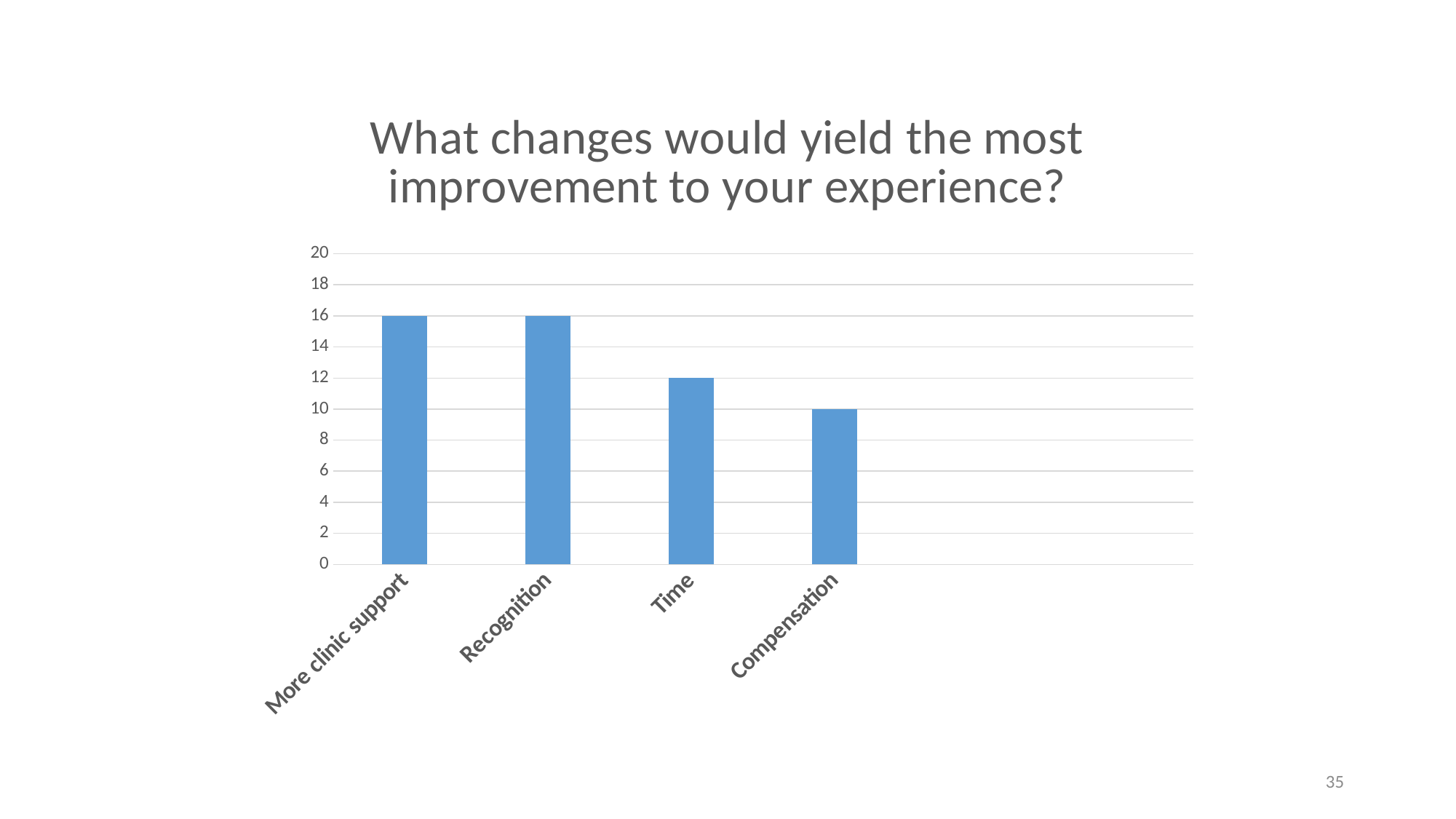
Which category has the lowest value? Compensation How many categories are shown on the x axis? 4 What is the difference between the values for Time and Compensation? 2 Which is larger, the value for Time or the value for Compensation? Time What is the value for Compensation? 10 Is the value for More clinic support greater or less than 14? greater What kind of chart is shown on the slide? bar chart What is the value for Recognition? 16 What is the value for More clinic support? 16 What is the value for Time? 12 What is the difference between the values for Recognition and Time? 4 What is the title of the chart? What changes would yield the most improvement to your experience?